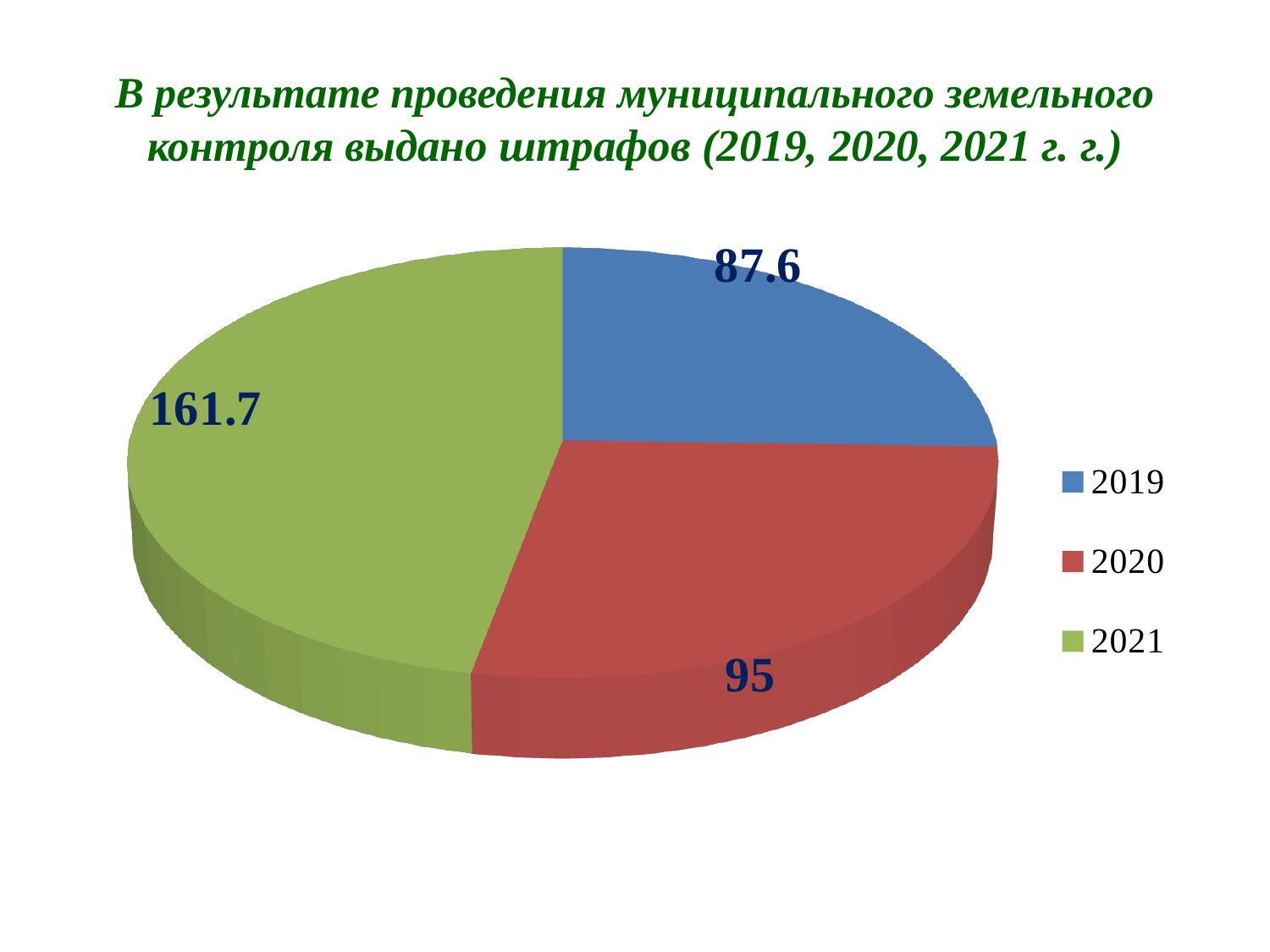
What is the difference between the values for 2020 and 2019? 7.4 What is the value for 2020? 95 What is the total of all three slices? 344.3 What is the value for 2019? 87.6 What is the difference between the values for 2021 and 2020? 66.7 Which year has the largest slice of the pie? 2021 How many slices does the pie chart have? 3 What is the value for 2021? 161.7 What colour is the slice for 2021? green Which is larger, the value for 2020 or the value for 2019? 2020 Which year has the smallest slice of the pie? 2019 What type of chart is shown on the slide? pie chart